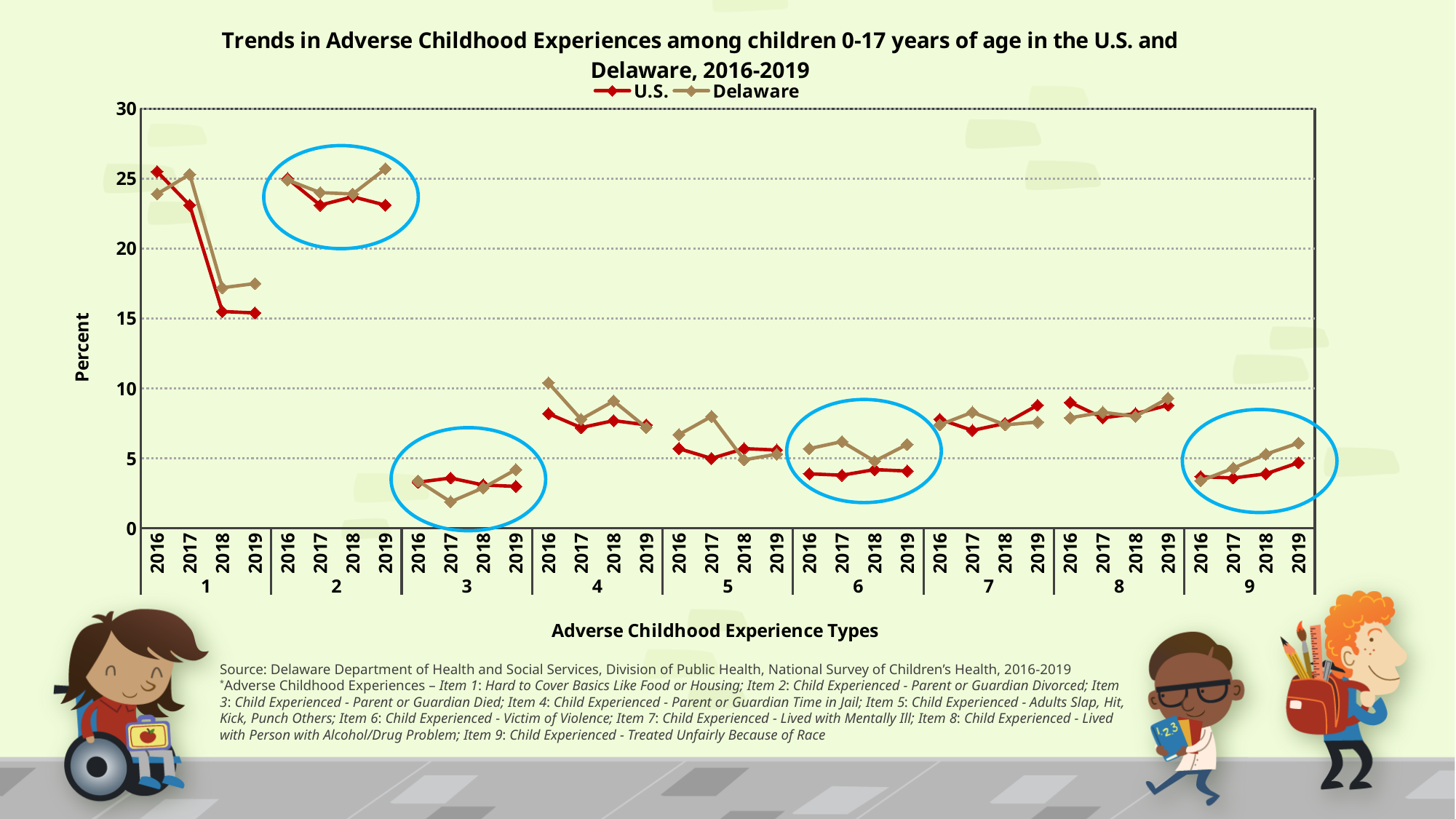
Is the Delaware value for ACE type 1 in 2018 greater or less than 20? less How many series does the legend list? 2 What is the label on the y axis? Percent How many years are plotted for each Adverse Childhood Experience type? 4 For ACE type 3 in 2017, which is larger, the U.S. value or the Delaware value? U.S. Is the U.S. value for ACE type 2 in 2017 greater or less than 25? less Is the Delaware value for ACE type 9 in 2019 greater or less than 5? greater Does the U.S. value for ACE type 1 rise or fall from 2016 to 2019? Fall How many Adverse Childhood Experience types are shown along the x axis? 9 For ACE type 1 in 2018, which is larger, the U.S. value or the Delaware value? Delaware What kind of chart is shown on the slide? Line chart